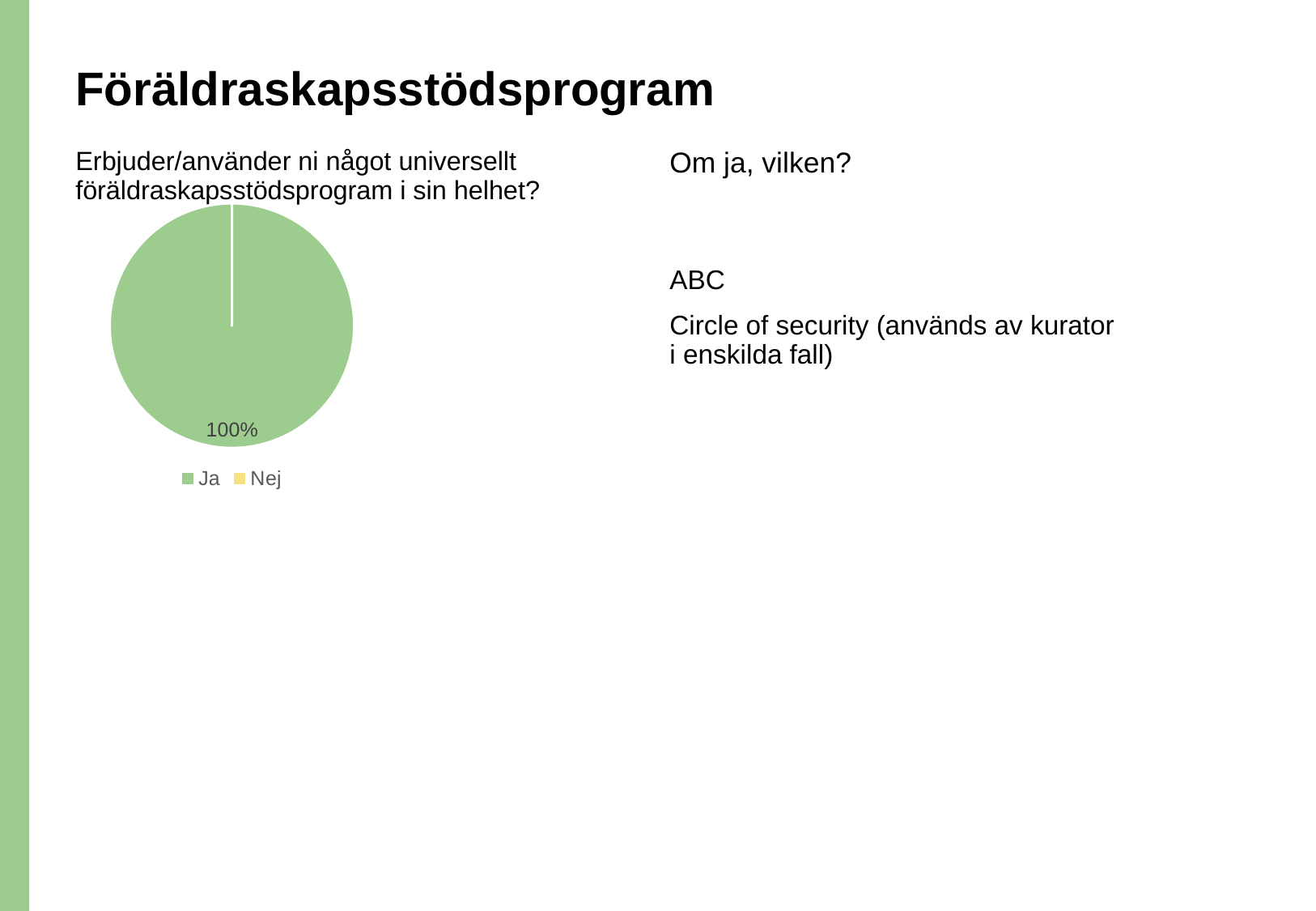
Which category has the largest share of the pie chart? Ja Which is larger in the pie chart, "Ja" or "Nej"? Ja What share of the pie does the "Ja" slice represent? 100% What percentage is shown for "Ja" in the pie chart? 100% What are the two legend entries of the pie chart? Ja and Nej Which category has the smallest share of the pie chart? Nej What colour represents "Ja" in the pie chart? green How many categories does the legend of the pie chart list? 2 What kind of chart is shown on the slide? pie chart